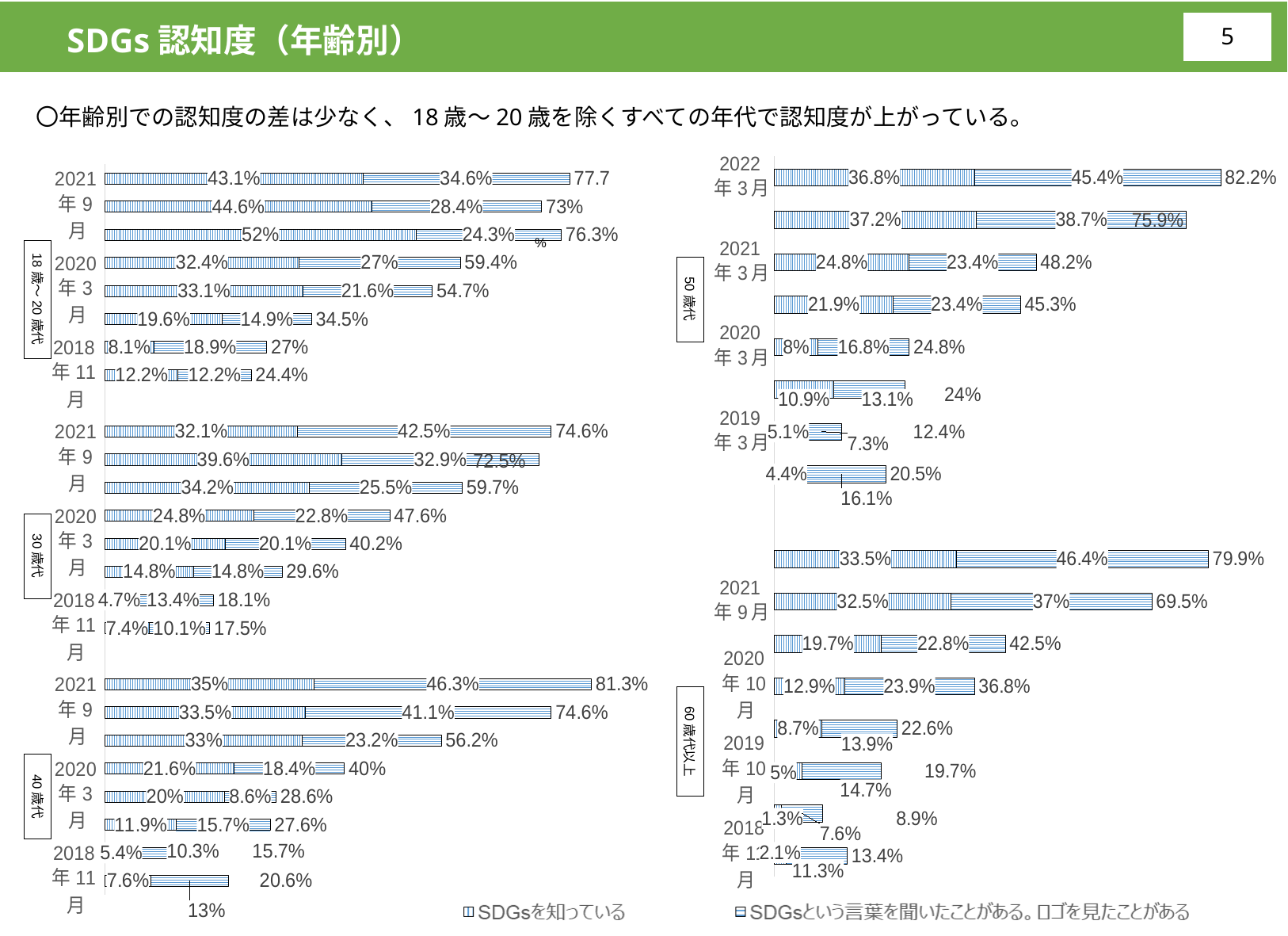
In the 18歳～20歳代 chart, what is the 'SDGsを知っている' value for the topmost bar? 43.1% Comparing the topmost bars of the 50歳代 chart and the 60歳代以上 chart, which has the larger total? 50歳代 In the 40歳代 chart, what is the total for the topmost bar? 81.3% In the 18歳～20歳代 chart, what is the total for the topmost bar? 77.7 In the 50歳代 chart, what is the difference between the 'SDGsという言葉を聞いたことがある。ロゴを見たことがある' value (45.4%) and the 'SDGsを知っている' value (36.8%) for the topmost bar? 8.6% In the 60歳代以上 chart, what is the 'SDGsという言葉を聞いたことがある。ロゴを見たことがある' value for the topmost bar? 46.4% Which is larger for the topmost bar of the 40歳代 chart: the 'SDGsを知っている' value or the 'SDGsという言葉を聞いたことがある。ロゴを見たことがある' value? SDGsという言葉を聞いたことがある。ロゴを見たことがある How many series does the legend list? 2 In the 30歳代 chart, what is the total for the topmost bar? 74.6% In the 50歳代 chart, what is the total for the topmost bar (2022年3月)? 82.2% What kind of chart is used on this slide? bar chart In the 60歳代以上 chart, what is the total for the bottom bar? 13.4%